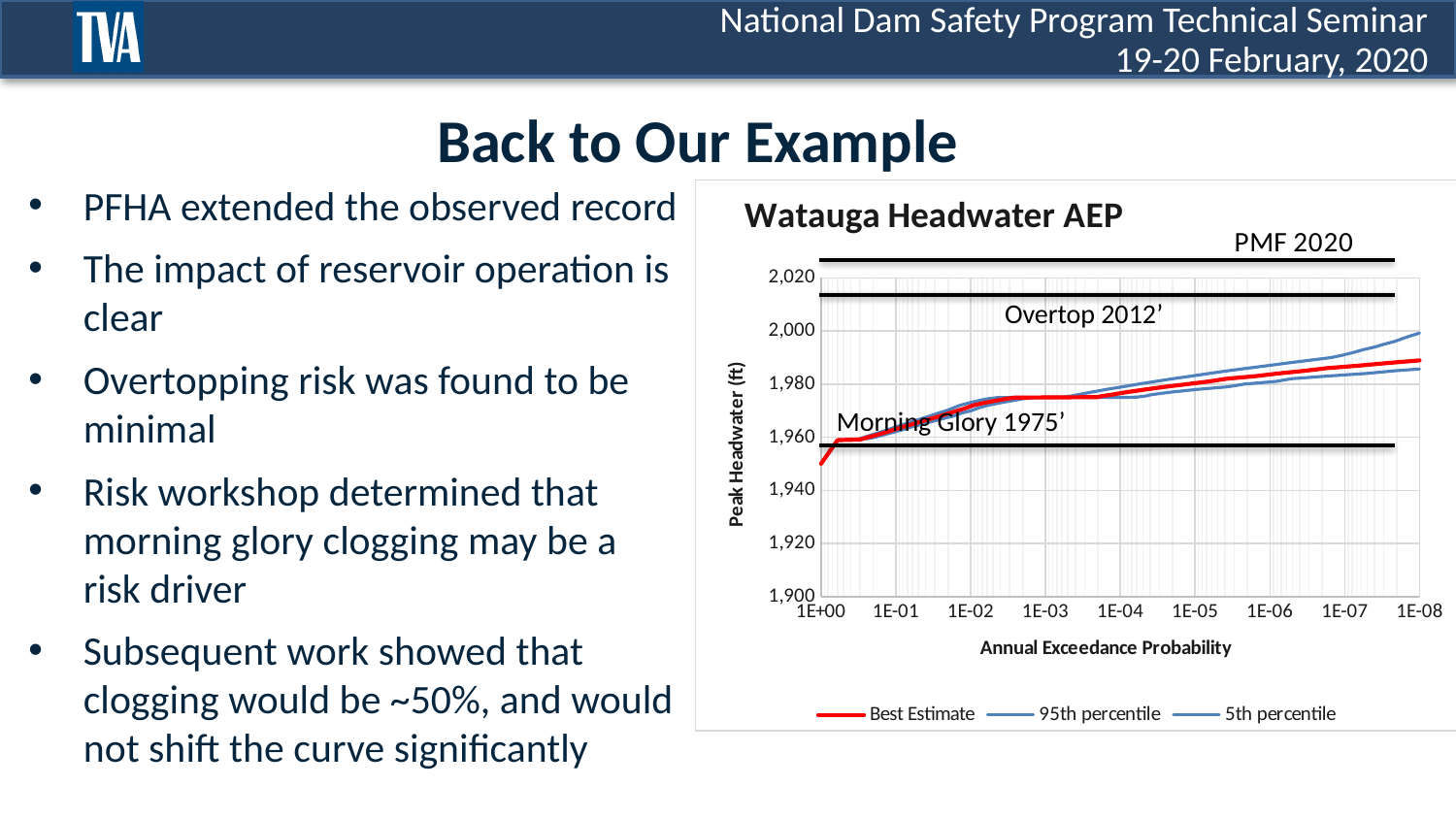
What is the title of the chart on the slide? Watauga Headwater AEP How many series does the chart legend list? 3 Is the Best Estimate value at 1E-08 greater or less than 1,980? greater What is the highest value shown on the vertical axis of the chart? 2,020 What kind of chart is shown on the slide? line chart Which series is drawn in red in the chart? Best Estimate Is the Best Estimate value at 1E+00 greater or less than 1,960? less What is the label of the vertical axis of the chart? Peak Headwater (ft) How many tick labels are shown on the horizontal axis of the chart? 9 Do the plotted curves rise or fall as you move along the x axis from 1E+00 to 1E-08? rise What is the label of the horizontal axis of the chart? Annual Exceedance Probability